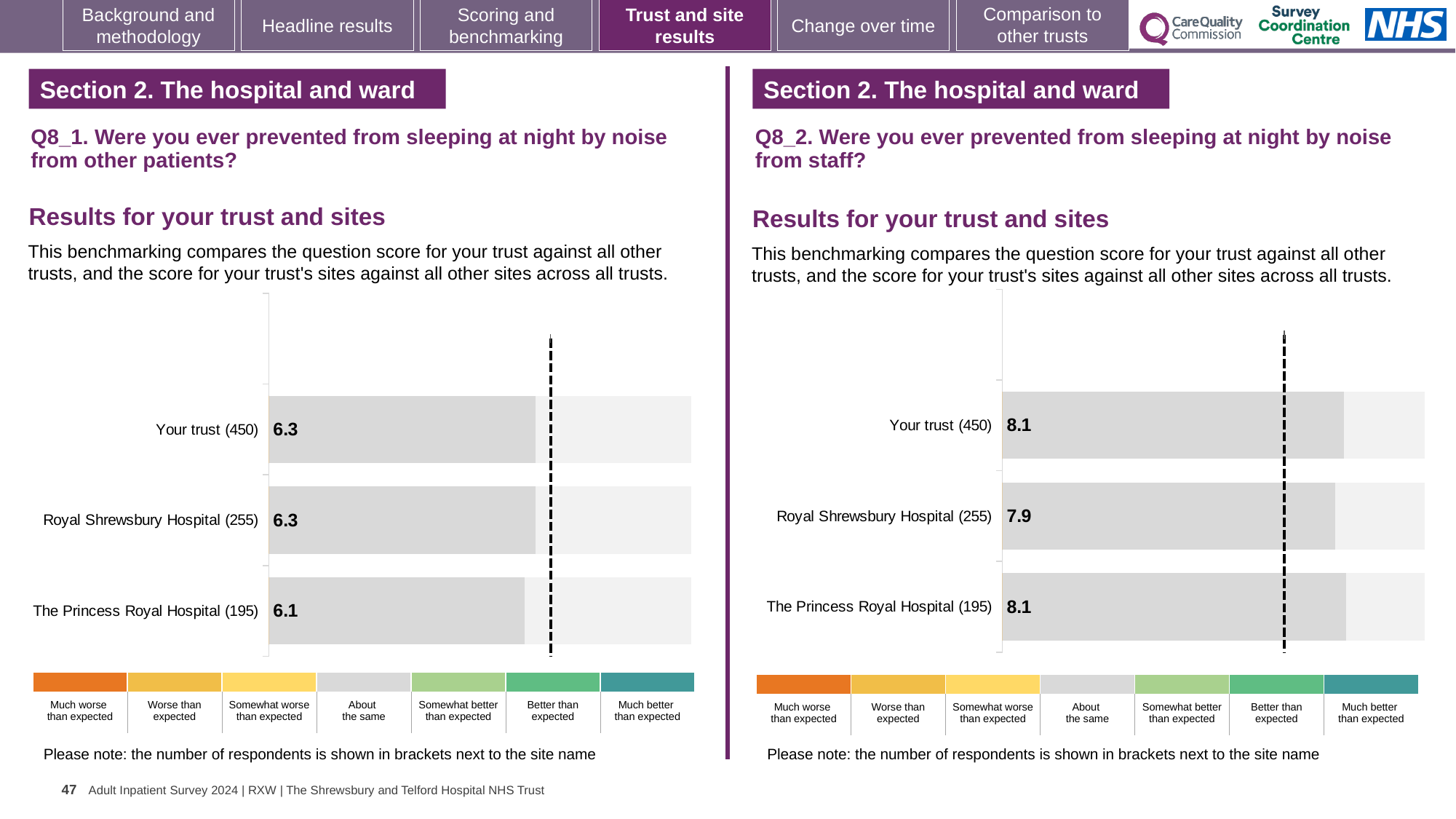
How many benchmark categories are shown in the colour legend below the Q8_1 chart? 7 In the Q8_1 chart (noise from other patients), what is the score for Your trust (450)? 6.3 How many bars are plotted in the Q8_1 chart (noise from other patients)? 3 In the Q8_1 chart (noise from other patients), which site or trust has the lowest score? The Princess Royal Hospital (195) In the Q8_2 chart (noise from staff), what is the score for Your trust (450)? 8.1 In the Q8_1 chart (noise from other patients), what is the difference between the scores for Royal Shrewsbury Hospital and The Princess Royal Hospital? 0.2 In the Q8_2 chart (noise from staff), what is the score for Royal Shrewsbury Hospital (255)? 7.9 In the Q8_2 chart (noise from staff), which site or trust has the lowest score? Royal Shrewsbury Hospital (255) In the Q8_1 chart (noise from other patients), what is the score for The Princess Royal Hospital (195)? 6.1 What type of chart is used in the Q8_2 chart (noise from staff)? Bar chart In the Q8_2 chart (noise from staff), what is the difference between the scores for Your trust and Royal Shrewsbury Hospital? 0.2 In the Q8_2 chart (noise from staff), which has the higher score: Royal Shrewsbury Hospital or The Princess Royal Hospital? The Princess Royal Hospital